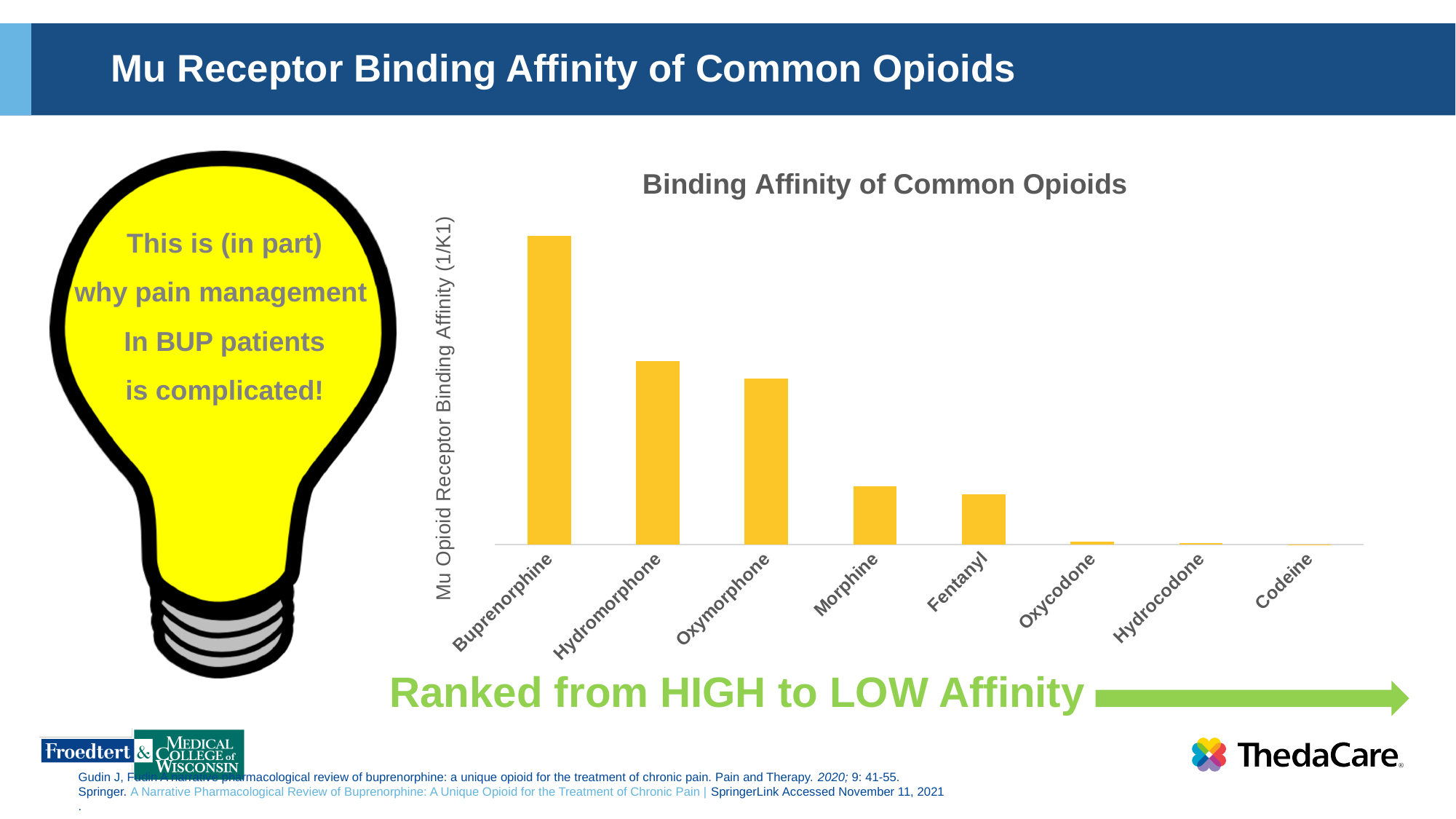
How many opioids are plotted on the chart? 8 Which has the higher binding affinity on the chart, Fentanyl or Oxycodone? Fentanyl Which has the higher binding affinity on the chart, Buprenorphine or Hydromorphone? Buprenorphine What is the title of the chart? Binding Affinity of Common Opioids Which opioid has the highest mu opioid receptor binding affinity on the chart? Buprenorphine Do the bar values rise or fall moving from left to right along the x axis? Fall Which has the higher binding affinity on the chart, Oxymorphone or Morphine? Oxymorphone What kind of chart is shown on the slide? Bar chart Which opioid is plotted first (leftmost) on the chart? Buprenorphine What is the label on the vertical axis of the chart? Mu Opioid Receptor Binding Affinity (1/K1)